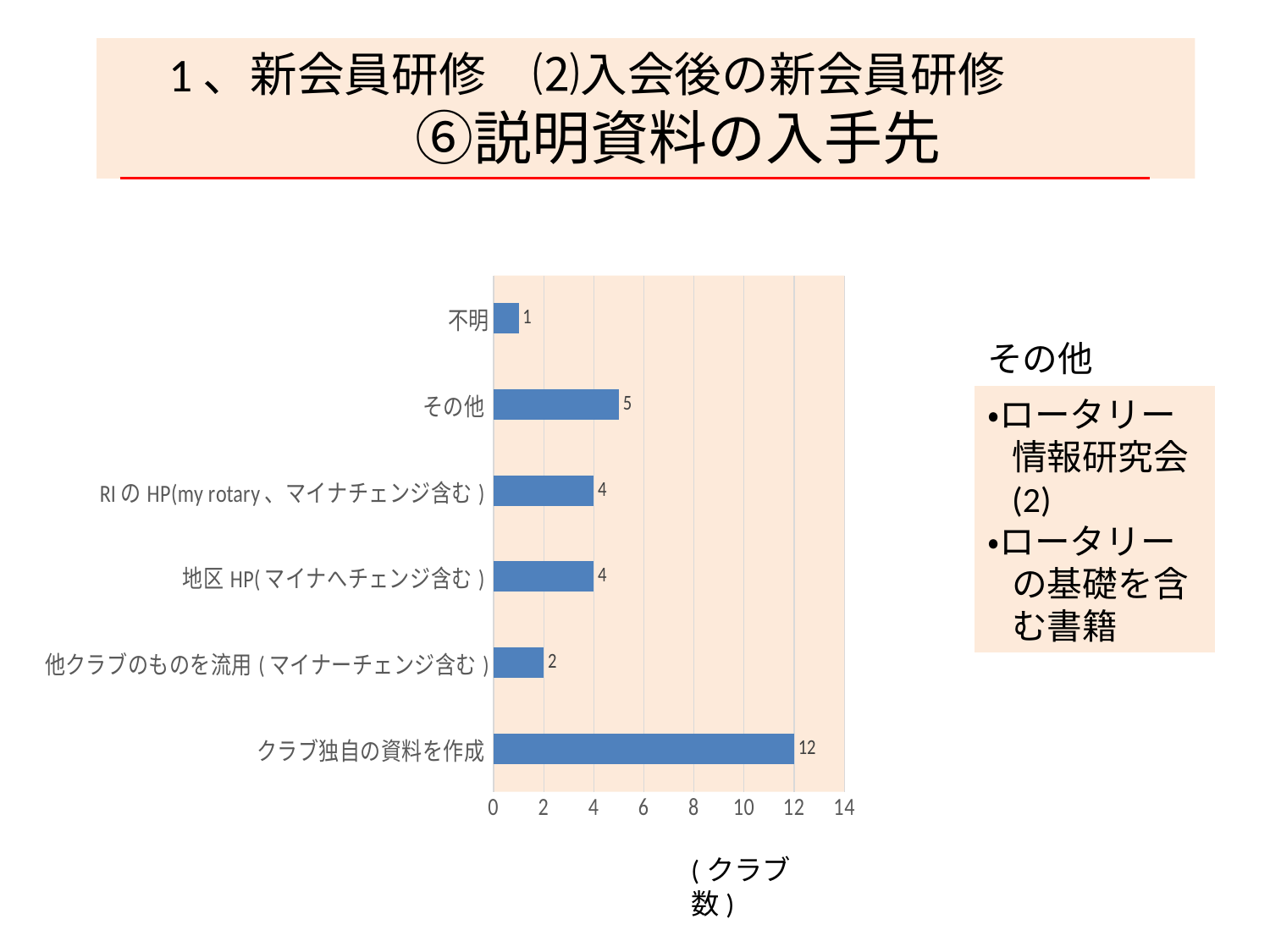
What is the maximum value shown on the horizontal axis? 14 What kind of chart is shown on the slide? bar chart What is the difference between the values for クラブ独自の資料を作成 and その他? 7 Which is larger, the value for その他 or the value for 地区HP(マイナへチェンジ含む)? その他 What is the value for 不明? 1 What is the value for 他クラブのものを流用(マイナーチェンジ含む)? 2 What is the value for クラブ独自の資料を作成? 12 What is the value for その他? 5 Which category has the highest value? クラブ独自の資料を作成 Which category has the lowest value? 不明 Is the value for クラブ独自の資料を作成 greater or less than 10? greater How many categories are shown in the chart? 6